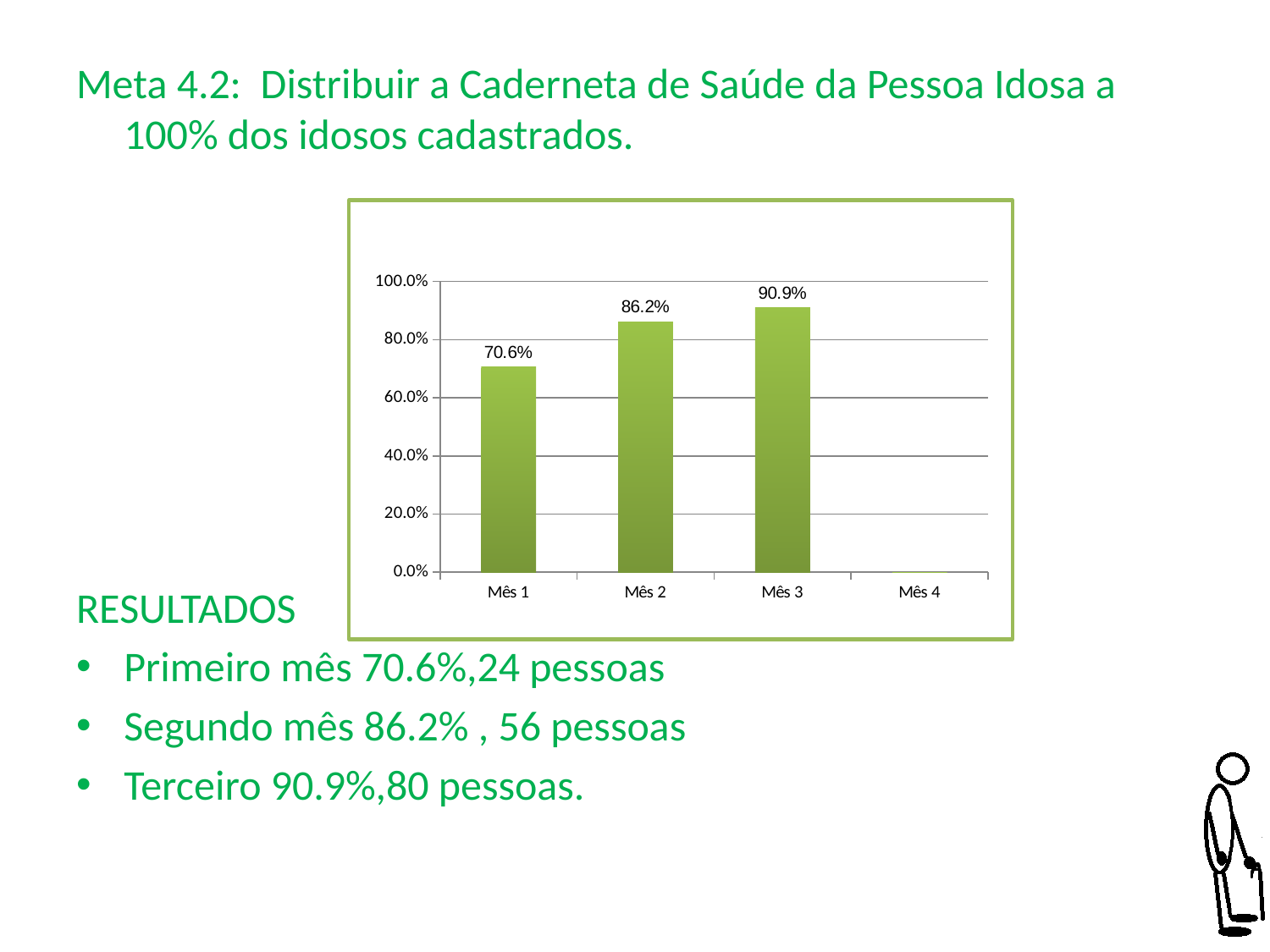
What kind of chart is shown on the slide? bar chart What is the difference between the values for Mês 3 and Mês 2? 4.7 percentage points Among Mês 1, Mês 2 and Mês 3, which has the lowest value? Mês 1 What is the value for Mês 2? 86.2% What is the difference between the values for Mês 2 and Mês 1? 15.6 percentage points Which is larger, the value for Mês 1 or the value for Mês 2? Mês 2 Which month has the highest value? Mês 3 What is the value for Mês 1? 70.6% What is the value for Mês 3? 90.9% How many categories are shown on the x axis? 4 Do the values rise or fall from Mês 1 to Mês 3? rise Is the value for Mês 1 greater or less than 80.0%? less